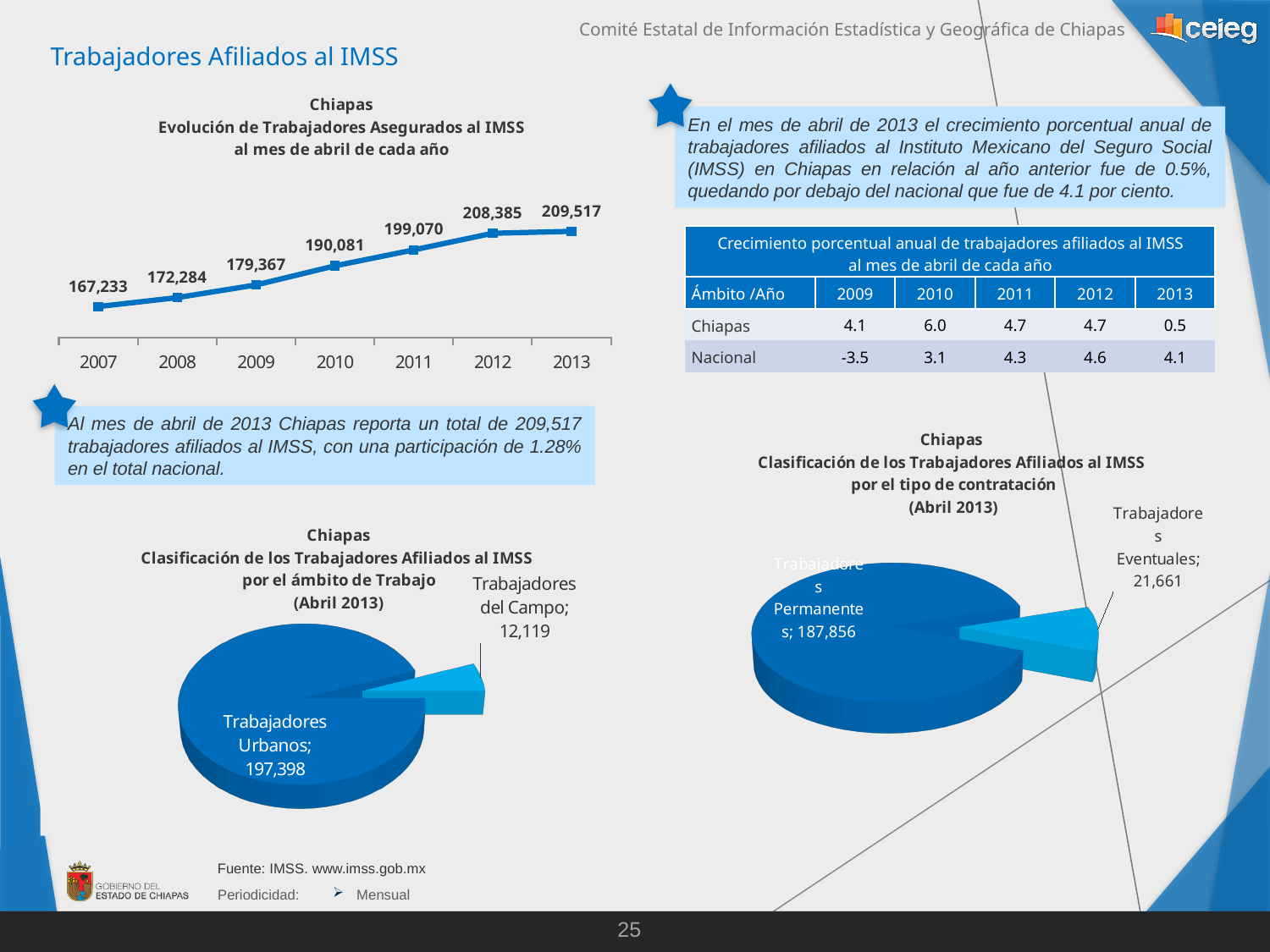
In the pie chart 'Clasificación de los Trabajadores Afiliados al IMSS por el ámbito de Trabajo', which slice is larger, Trabajadores Urbanos or Trabajadores del Campo? Trabajadores Urbanos In the line chart 'Evolución de Trabajadores Asegurados al IMSS', how many years are plotted? 7 In the pie chart 'Clasificación de los Trabajadores Afiliados al IMSS por el tipo de contratación', what is the difference between Trabajadores Permanentes and Trabajadores Eventuales? 166,195 In the line chart 'Evolución de Trabajadores Asegurados al IMSS', which year has the lowest value? 2007 In the line chart 'Evolución de Trabajadores Asegurados al IMSS', which year has the highest value? 2013 In the pie chart 'Clasificación de los Trabajadores Afiliados al IMSS por el tipo de contratación', what is the value for Trabajadores Eventuales? 21,661 What kind of chart is 'Evolución de Trabajadores Asegurados al IMSS'? line chart In the pie chart 'Clasificación de los Trabajadores Afiliados al IMSS por el ámbito de Trabajo', what is the value for Trabajadores del Campo? 12,119 In the line chart 'Evolución de Trabajadores Asegurados al IMSS', do the values rise or fall from 2007 to 2013? rise How many slices does the pie chart 'Clasificación de los Trabajadores Afiliados al IMSS por el tipo de contratación' have? 2 In the line chart 'Evolución de Trabajadores Asegurados al IMSS', what is the difference between the 2013 and 2007 values? 42,284 In the line chart 'Evolución de Trabajadores Asegurados al IMSS', what is the value for 2010? 190,081